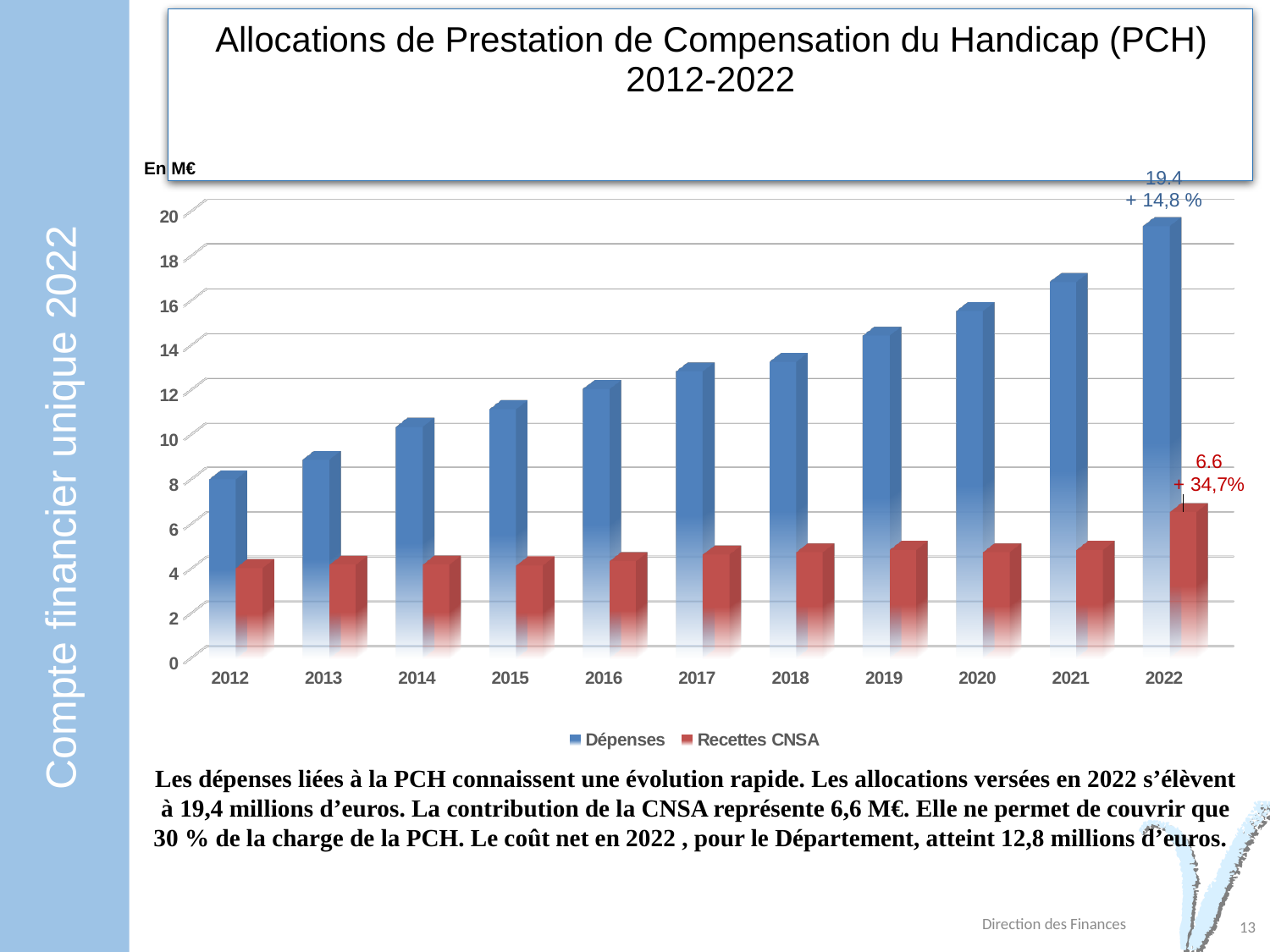
Is the value of Dépenses for 2012 greater or less than 10? less What unit is indicated for the values on the chart? En M€ How many years are shown on the x axis? 11 How many series does the legend list? 2 Is the value of Recettes CNSA for 2015 greater or less than 6? less Do the Dépenses values rise or fall from 2012 to 2022? Rise In which year are Dépenses the lowest? 2012 What is the difference between Dépenses and Recettes CNSA in 2022? 12.8 In which year are Dépenses the highest? 2022 What kind of chart is shown on the slide? Bar chart What is the value of Recettes CNSA for 2022? 6.6 What is the value of Dépenses for 2022? 19.4